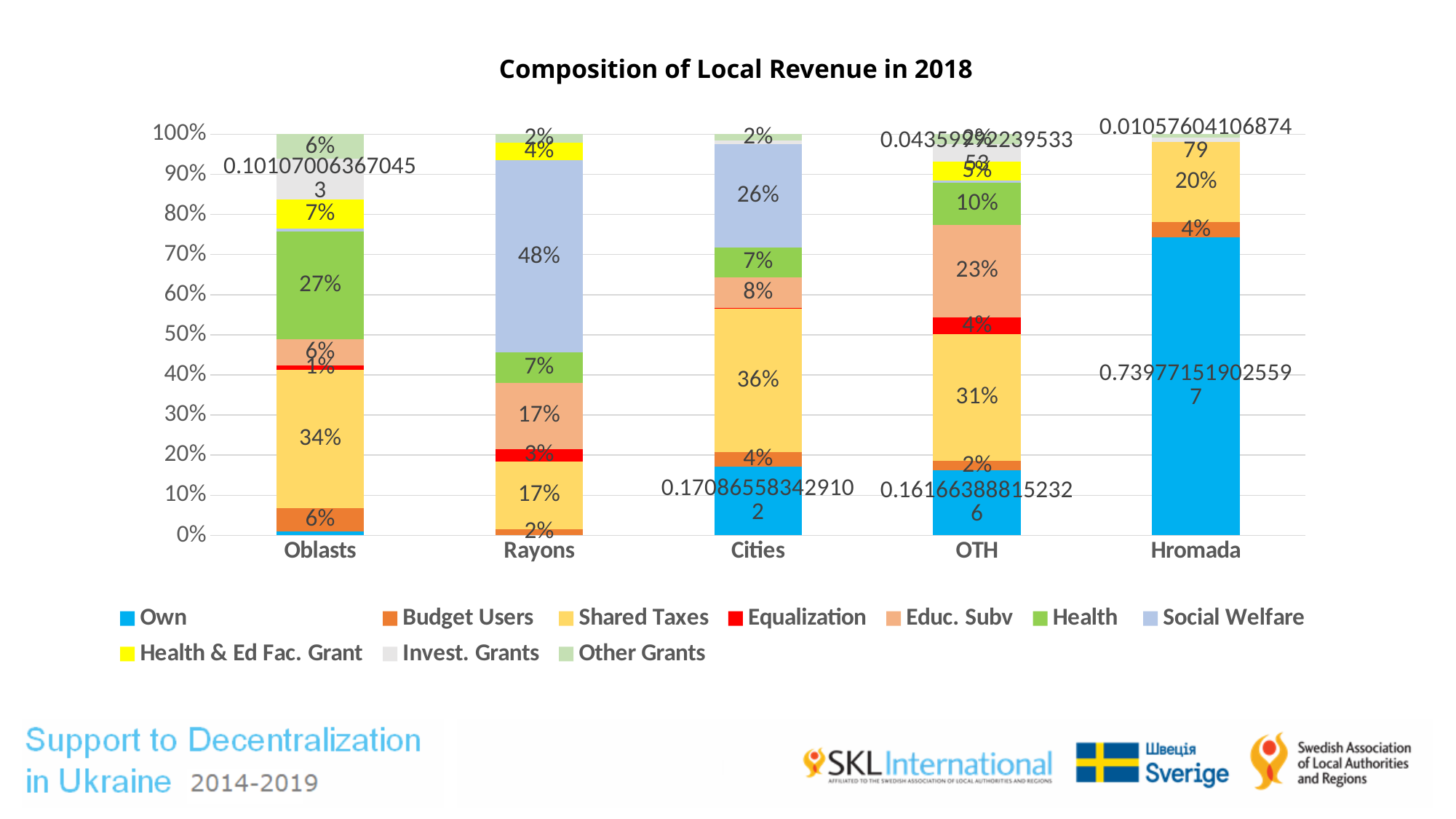
What is the Educ. Subv share for OTH? 23% Is the Own share for Hromada greater or less than 70%? greater What is the title of the chart? Composition of Local Revenue in 2018 How many series does the legend list? 10 Which has a larger Shared Taxes share, Oblasts or Cities? Cities What is the Shared Taxes share for Hromada? 20% What is the Social Welfare share for Rayons? 48% What is the Shared Taxes share for Cities? 36% What kind of chart is shown on the slide? Stacked bar chart How many categories are shown on the x axis of the chart? 5 Which category has the largest Social Welfare share? Rayons What is the Health share for Oblasts? 27%